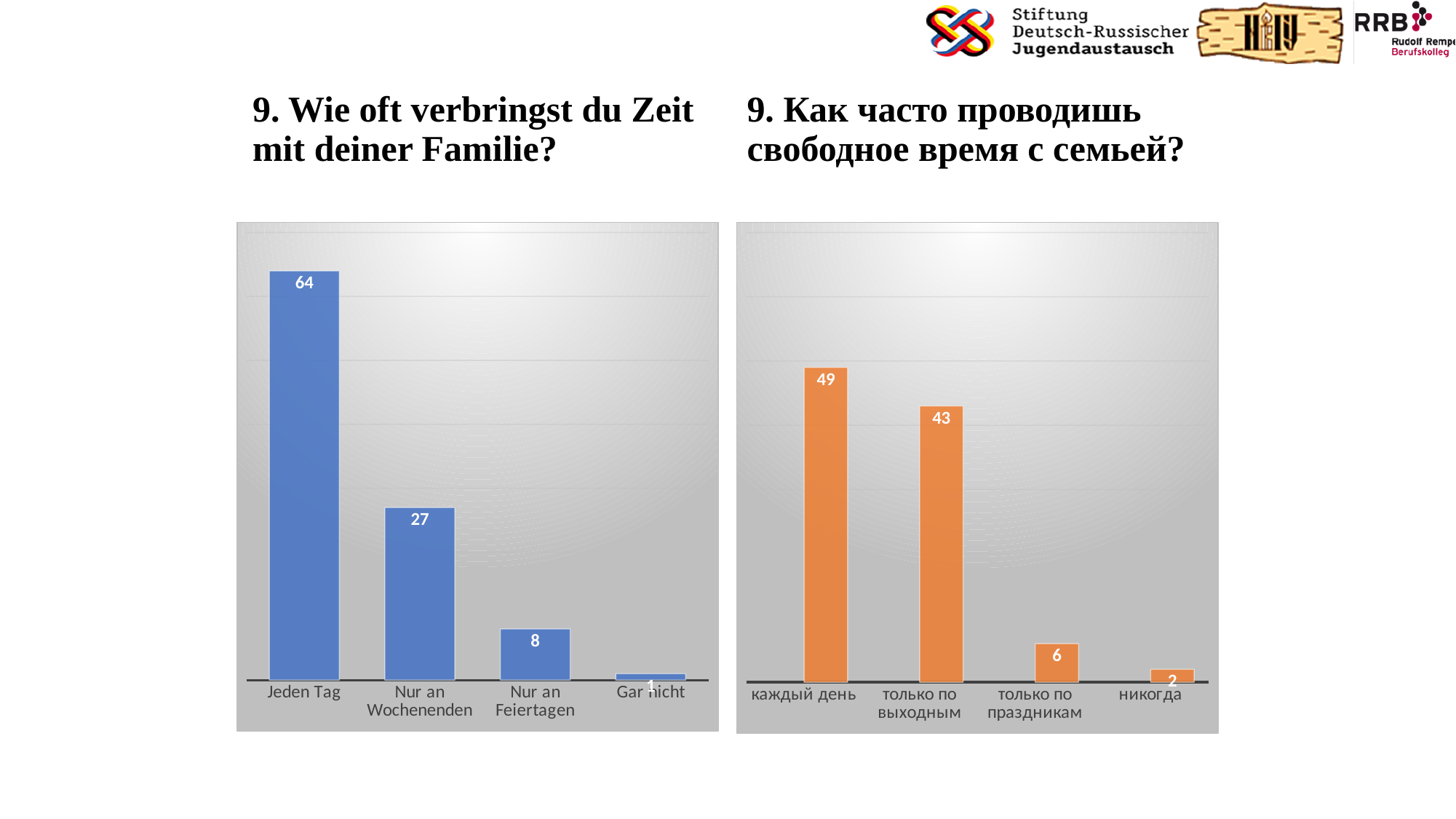
In the right chart (Как часто проводишь свободное время с семьей?), what is the value for каждый день? 49 In the right chart, which category has the highest value? каждый день In the left chart, what is the value for Nur an Wochenenden? 27 In the right chart, what is the value for только по праздникам? 6 In the right chart, what is the difference between каждый день and только по выходным? 6 In the left chart, how many categories are shown? 4 In the left chart, what is the difference between Jeden Tag and Nur an Wochenenden? 37 What colour are the bars in the left chart? Blue What type of chart is the right chart? Bar chart In the right chart, which is larger: только по праздникам or никогда? только по праздникам In the left chart, which category has the lowest value? Gar nicht In the left chart (Wie oft verbringst du Zeit mit deiner Familie?), what is the value for Jeden Tag? 64